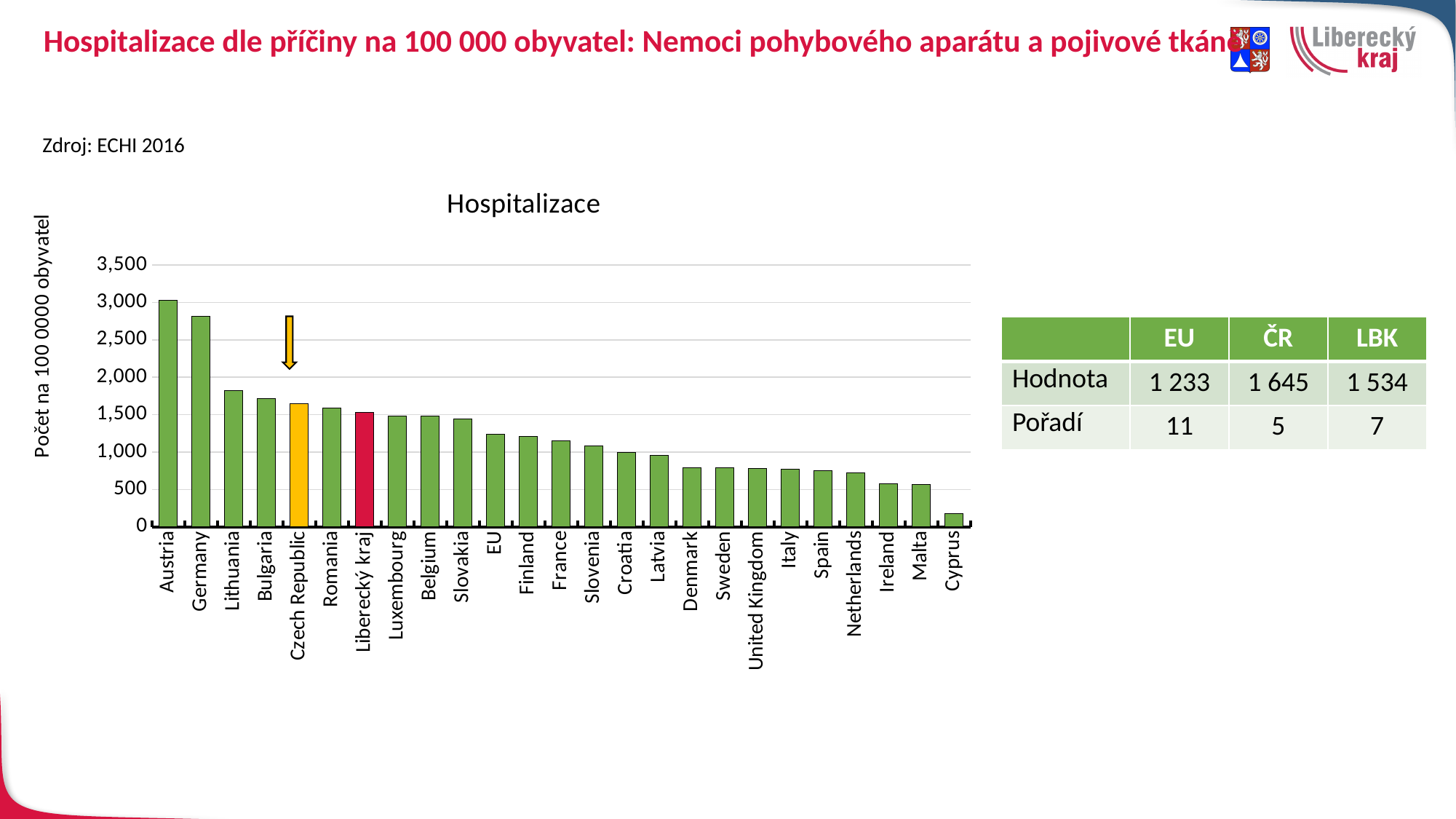
What is the title of the chart? Hospitalizace Do the values rise or fall moving from left to right along the x axis? fall What is the value for the Czech Republic (ČR) according to the table on the slide? 1 645 What is the value for the EU according to the table on the slide? 1 233 Which is larger, the value for Austria or the value for Germany? Austria What is the value for Liberecký kraj (LBK) according to the table on the slide? 1 534 Is the value for Lithuania greater or less than 1,500? greater Which category has the lowest value in the chart? Cyprus What type of chart is shown on the slide? bar chart What is the difference between the values for the Czech Republic and Liberecký kraj? 111 How many categories are plotted on the x axis of the chart? 25 Which category has the highest value in the chart? Austria